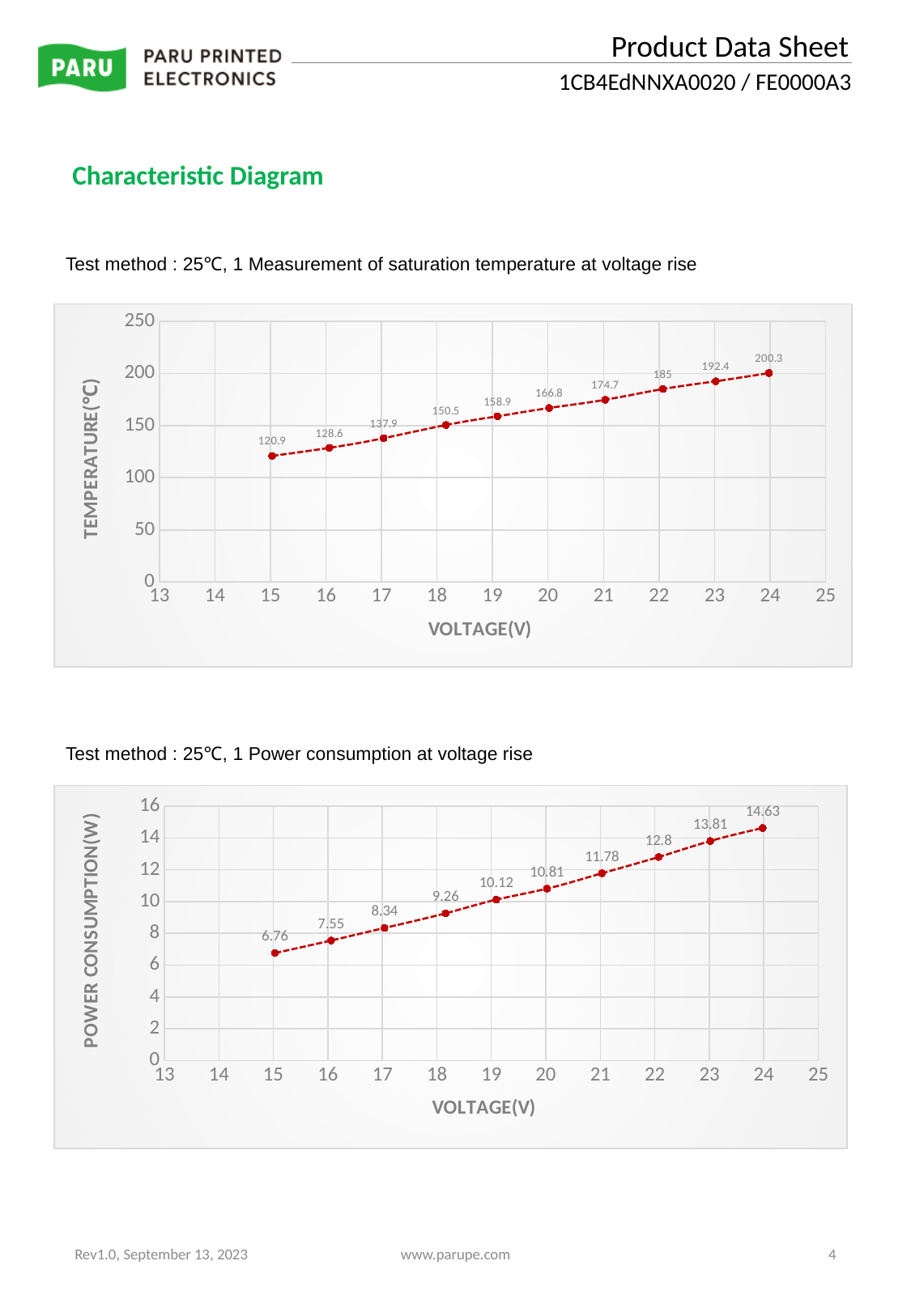
In the top chart (temperature vs voltage), what is the temperature at 22 V? 185 In the bottom chart (power consumption vs voltage), what is the power consumption at 24 V? 14.63 In the top chart (temperature vs voltage), what is the difference between the temperature at 24 V and at 15 V? 79.4 In the bottom chart (power consumption vs voltage), what is the power consumption at 19 V? 10.12 What kind of chart is the bottom chart (power consumption vs voltage)? line chart In the top chart (temperature vs voltage), how many data points are plotted? 10 In the bottom chart (power consumption vs voltage), what is the difference between the power consumption at 17 V and at 16 V? 0.79 In the top chart (temperature vs voltage), do the values rise or fall as voltage increases? rise In the top chart (temperature vs voltage), at which voltage is the temperature lowest? 15 In the bottom chart (power consumption vs voltage), is the value at 21 V greater or less than 12? less In the top chart (temperature vs voltage), what is the temperature at 18 V? 150.5 In the top chart (temperature vs voltage), at which voltage is the temperature highest? 24